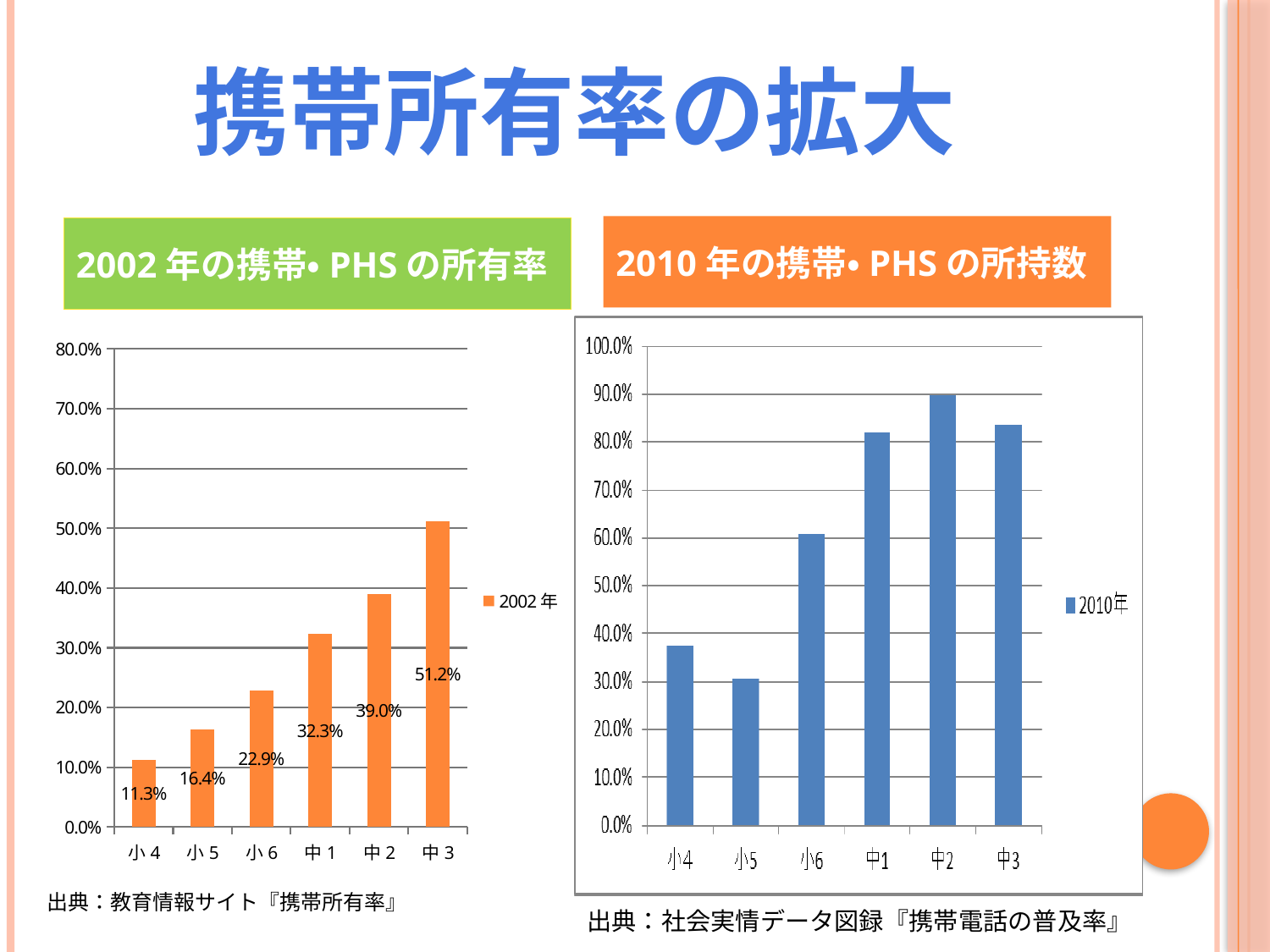
In the left chart (2002年の携帯・PHSの所有率), which is larger, the value for 小6 or the value for 小5? 小6 What kind of chart is the left chart (2002年の携帯・PHSの所有率)? bar chart In the left chart (2002年の携帯・PHSの所有率), which category has the lowest value? 小4 In the left chart (2002年の携帯・PHSの所有率), which category has the highest value? 中3 In the right chart (2010年の携帯・PHSの所持数), which category has the highest value? 中2 In the left chart (2002年の携帯・PHSの所有率), what is the value for 小4? 11.3% In the left chart (2002年の携帯・PHSの所有率), what is the value for 中3? 51.2% In the right chart (2010年の携帯・PHSの所持数), is the value for 小5 greater or less than 40.0%? less In the right chart (2010年の携帯・PHSの所持数), is the value for 中2 greater or less than 80.0%? greater In the left chart (2002年の携帯・PHSの所有率), what is the value for 中1? 32.3% How many categories are shown on the x axis of the right chart (2010年の携帯・PHSの所持数)? 6 In the left chart (2002年の携帯・PHSの所有率), what is the difference between the values for 中3 and 中2? 12.2%